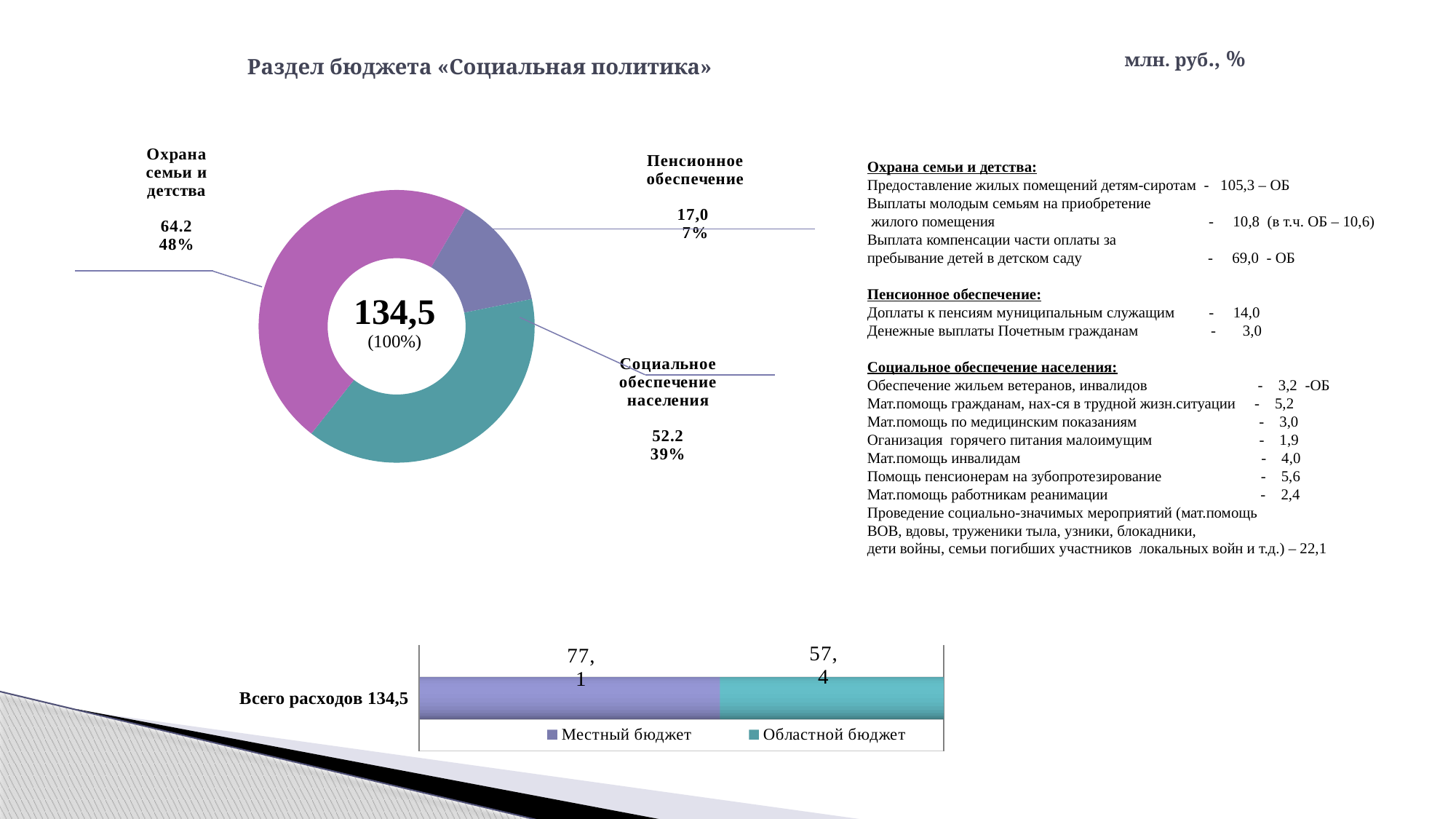
On the bottom bar chart, what is the value for «Местный бюджет»? 77,1 On the donut chart, what total value is shown in the centre? 134,5 On the donut chart, which category has the largest share? Охрана семьи и детства On the donut chart, what is the value for «Охрана семьи и детства»? 64.2 On the donut chart, which category has the smallest share? Пенсионное обеспечение On the donut chart, what is the value for «Социальное обеспечение населения»? 52.2 On the donut chart, what percentage share is shown for «Пенсионное обеспечение»? 7% On the bottom bar chart, which is larger, «Местный бюджет» or «Областной бюджет»? Местный бюджет On the donut chart, how many categories are shown? 3 On the bottom bar chart, what is the value for «Областной бюджет»? 57,4 On the bottom bar chart, how many series does the legend list? 2 On the donut chart, what percentage share is shown for «Социальное обеспечение населения»? 39%